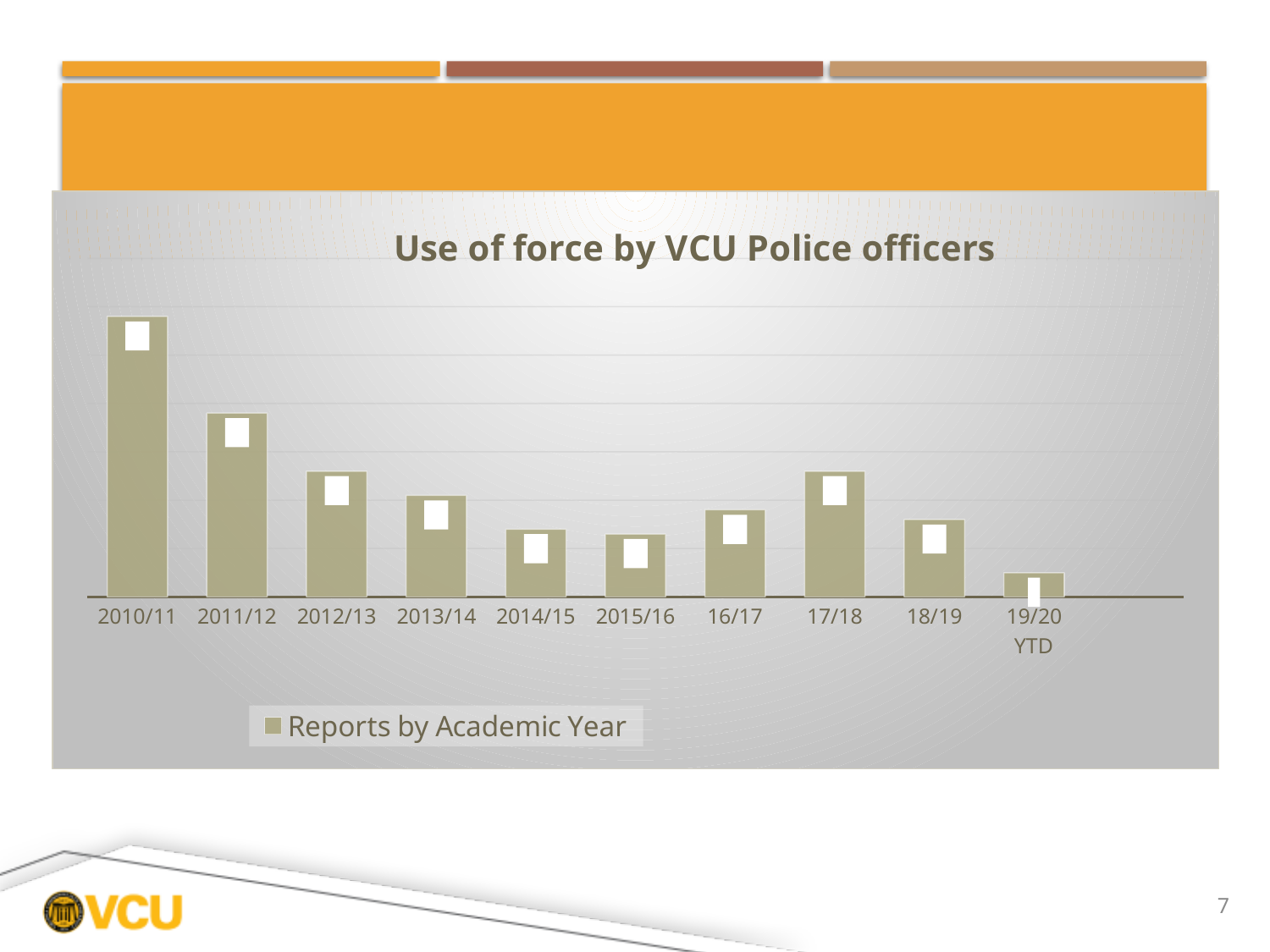
Which academic year has the lowest number of reports? 19/20 YTD Do the values rise or fall from 17/18 to 19/20 YTD? fall How many series does the legend list? 1 What type of chart is shown on the slide? bar chart Which has more reports, 16/17 or 17/18? 17/18 Do the values rise or fall from 2010/11 to 2015/16? fall What is the title of the chart? Use of force by VCU Police officers What series name does the legend show? Reports by Academic Year Which has more reports, 17/18 or 18/19? 17/18 How many academic years are shown on the x axis? 10 Which has more reports, 2010/11 or 2011/12? 2010/11 Which academic year has the highest number of reports? 2010/11